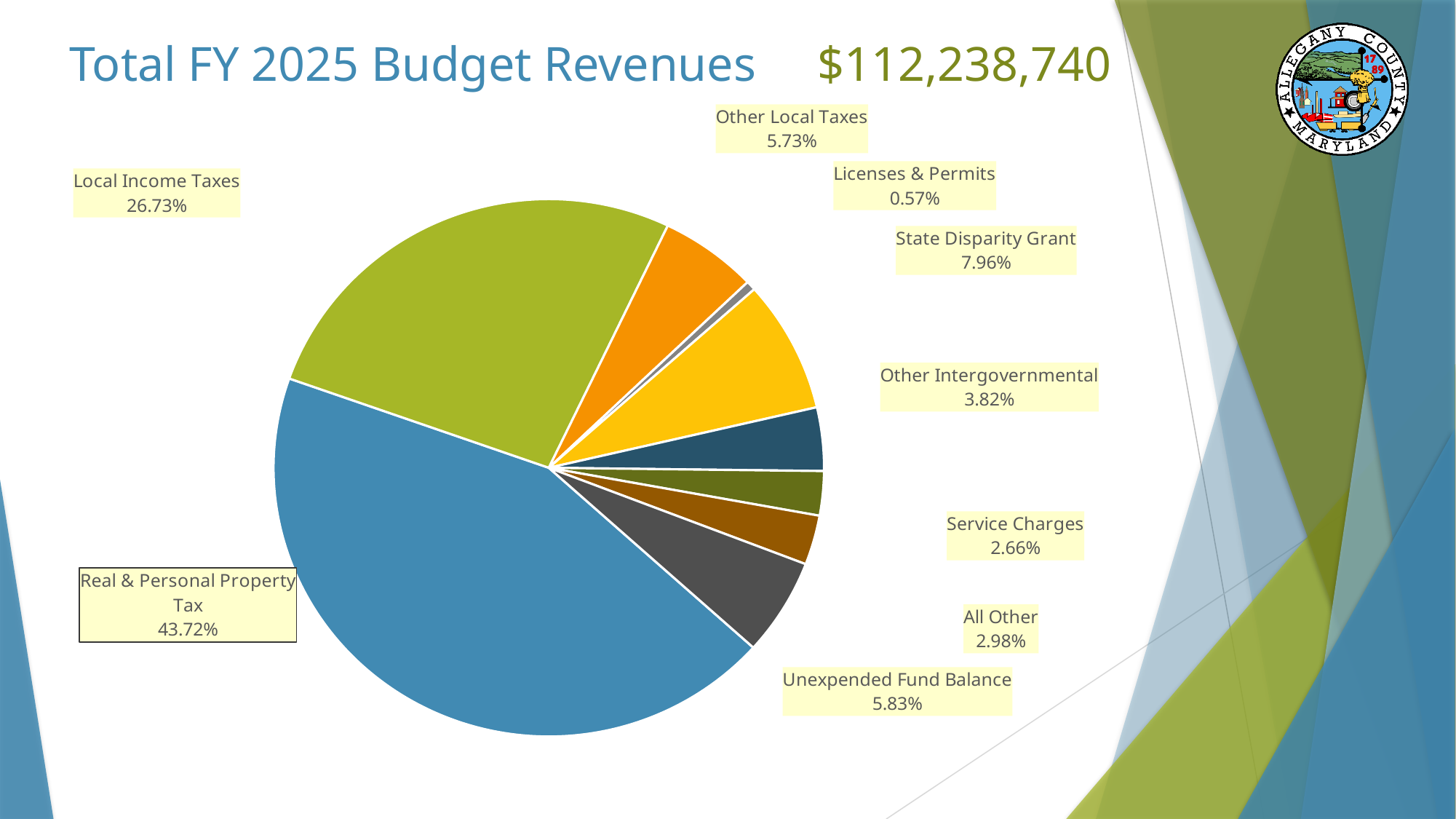
What is the difference in percentage points between Real & Personal Property Tax and Local Income Taxes? 16.99 Which is larger, the share for Other Local Taxes or the share for Unexpended Fund Balance? Unexpended Fund Balance Which revenue category has the largest share of the pie? Real & Personal Property Tax What kind of chart is shown on the slide? Pie chart What percentage of revenues is Local Income Taxes? 26.73% Which is larger, Service Charges or All Other? All Other Which revenue category has the smallest share of the pie? Licenses & Permits What total revenue amount is shown in the slide title? $112,238,740 What share of FY 2025 budget revenues comes from Real & Personal Property Tax? 43.72% How many revenue categories are shown in the pie chart? 9 What percentage is shown for Licenses & Permits? 0.57% What is the share for State Disparity Grant? 7.96%